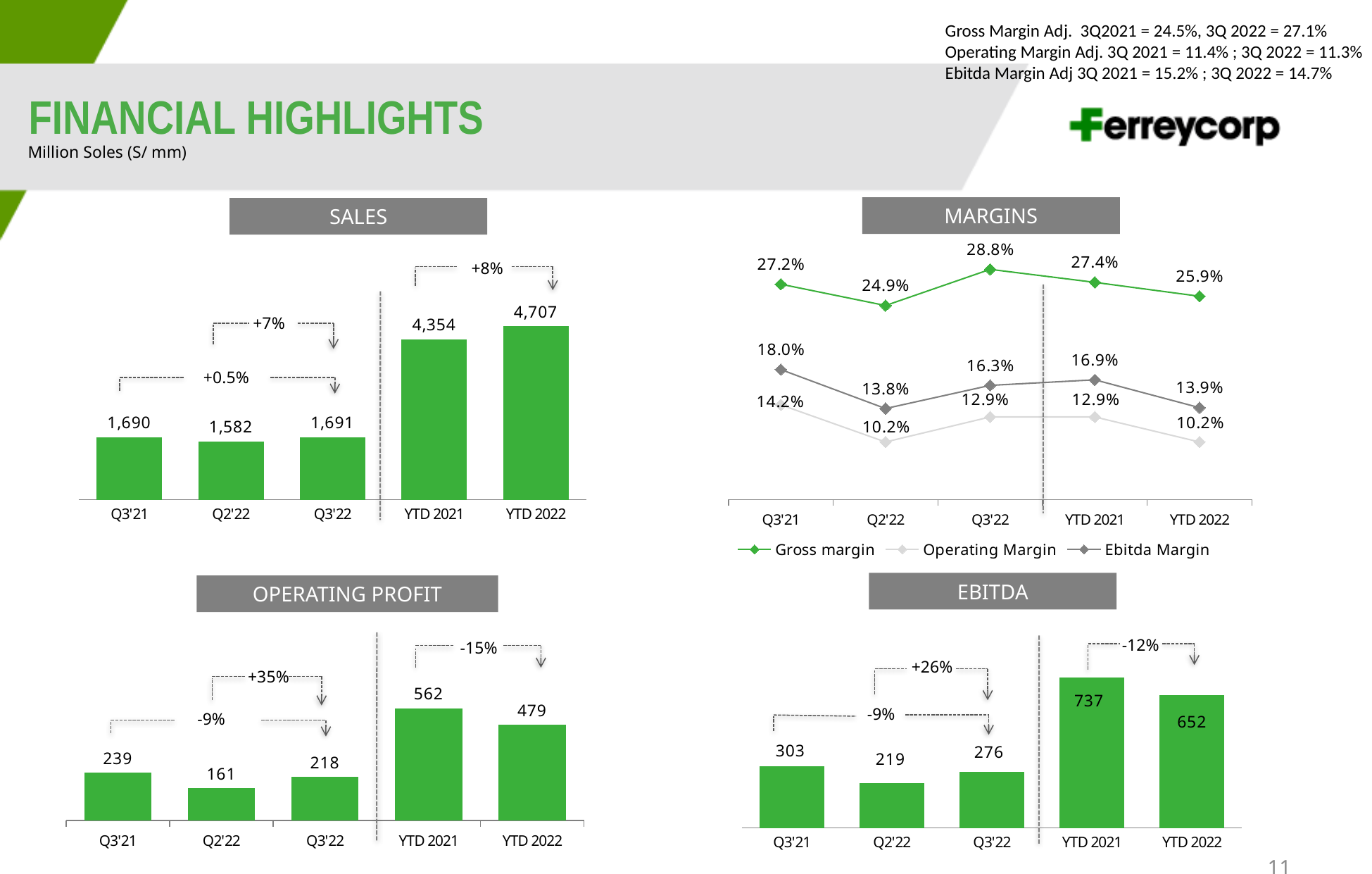
In the EBITDA chart, which is larger, Q3'21 or Q3'22? Q3'21 In the SALES chart, what is the value for YTD 2022? 4,707 In the EBITDA chart, what is the value for Q3'22? 276 In the SALES chart, what is the value for Q2'22? 1,582 In the OPERATING PROFIT chart, what is the difference between YTD 2021 and YTD 2022? 83 What kind of chart is the SALES chart? bar chart In the MARGINS chart, what is the Ebitda Margin for YTD 2022? 13.9% In the MARGINS chart, which period has the highest Gross margin? Q3'22 In the OPERATING PROFIT chart, which period has the lowest value? Q2'22 In the MARGINS chart, what is the Gross margin for Q3'22? 28.8% In the SALES chart, what is the difference between YTD 2022 and YTD 2021? 353 How many series does the legend of the MARGINS chart list? 3